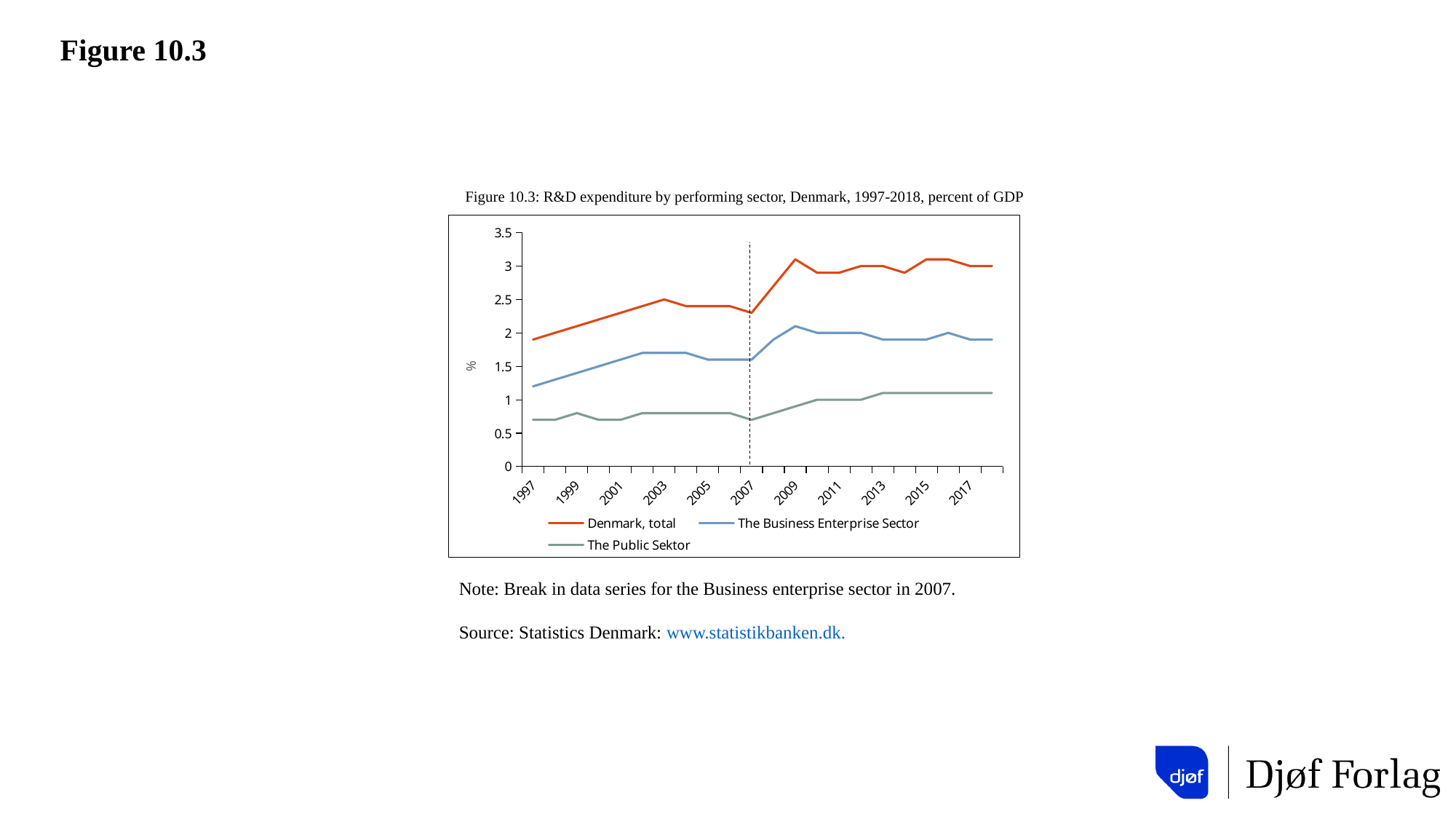
How many series does the legend of the chart list? 3 Which series has the lowest values across the whole period? The Public Sektor What is the title of the chart? Figure 10.3: R&D expenditure by performing sector, Denmark, 1997-2018, percent of GDP Which series has the highest value in 2015? Denmark, total What kind of chart is shown in Figure 10.3? line chart In 2005, which is larger: the value for Denmark, total or the value for The Public Sektor? Denmark, total Is the value for Denmark, total in 2009 greater or less than 2.5? greater Is the value for The Business Enterprise Sector in 1997 greater or less than 1.5? less At which year is the dashed vertical line drawn on the chart? 2007 Is the value for The Public Sektor in 2017 greater or less than 1.5? less Does the Denmark, total series rise or fall between 1997 and 2003? rise